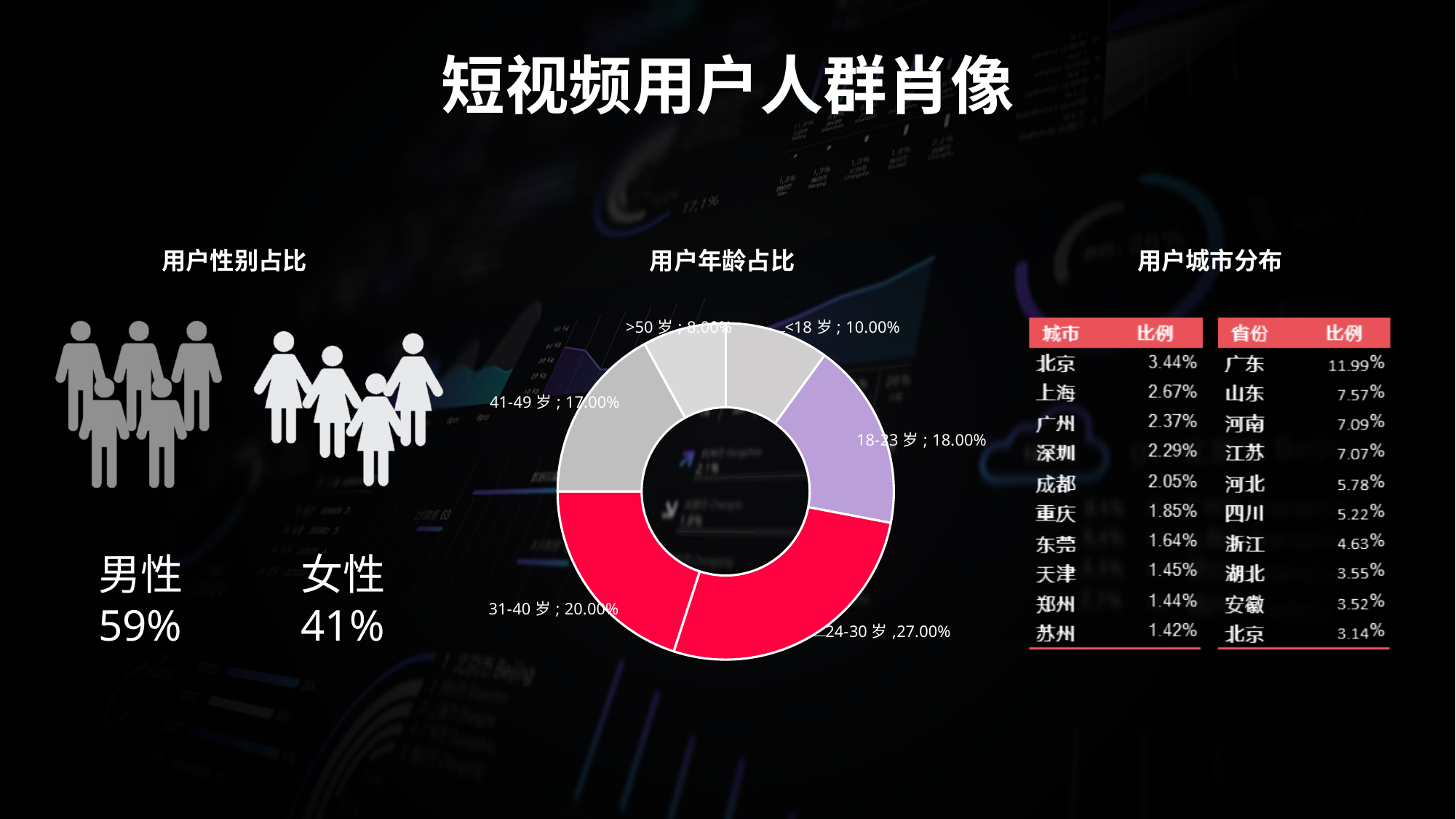
In the 用户年龄占比 chart, what share do users aged 41-49 岁 have? 17.00% What kind of chart is the 用户年龄占比 chart? Doughnut chart In the 用户年龄占比 chart, which age group has the largest share? 24-30 岁 In the 用户年龄占比 chart, what share do users aged 31-40 岁 have? 20.00% In the 用户年龄占比 chart, what share do users aged 24-30 岁 have? 27.00% What is the title of the chart in the middle of the slide? 用户年龄占比 In the 用户年龄占比 chart, what share do users aged <18 岁 have? 10.00% In the 用户年龄占比 chart, what is the difference between the shares of 31-40 岁 and >50 岁? 12.00% In the 用户年龄占比 chart, which age group has the smallest share? >50 岁 In the 用户年龄占比 chart, which has a larger share, 41-49 岁 or 18-23 岁? 18-23 岁 In the 用户年龄占比 chart, what is the difference between the shares of 24-30 岁 and 18-23 岁? 9.00% How many age groups are shown in the 用户年龄占比 chart? 6